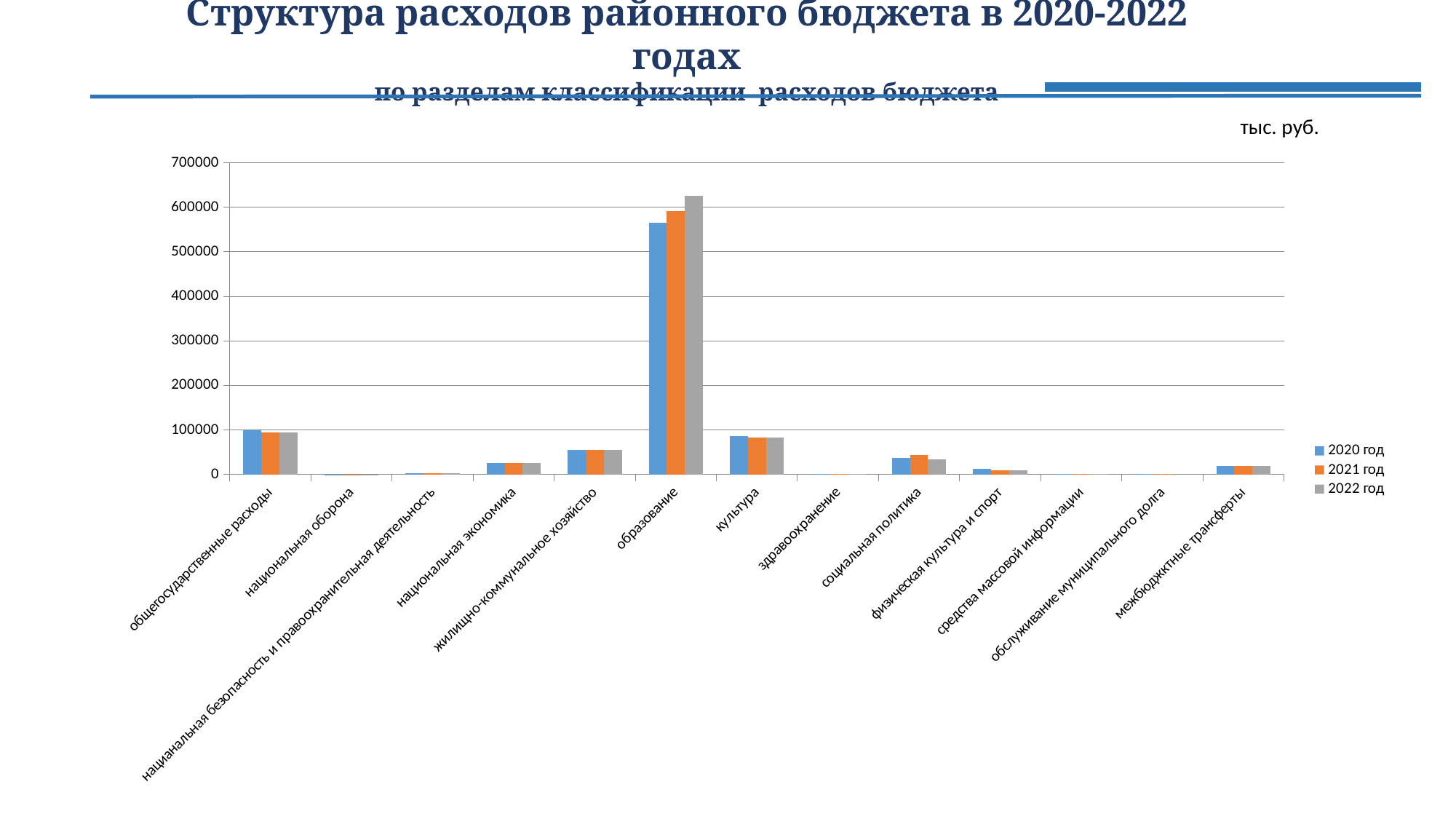
Is the value for образование in 2020 год greater or less than 500000? greater What unit of measurement is indicated above the chart? тыс. руб. Which is larger for образование: the value for 2020 год or the value for 2022 год? 2022 год Which category has the highest expenditure in every year shown? образование Is the value for образование in 2022 год greater or less than 600000? greater Is the value for общегосударственные расходы in 2020 год greater or less than 200000? less What kind of chart is shown on the slide? bar chart Which category has the larger value in 2021 год: образование or культура? образование How many series does the legend list? 3 How many expenditure categories are shown along the x axis? 13 Do the values for образование rise or fall from 2020 год to 2022 год? rise